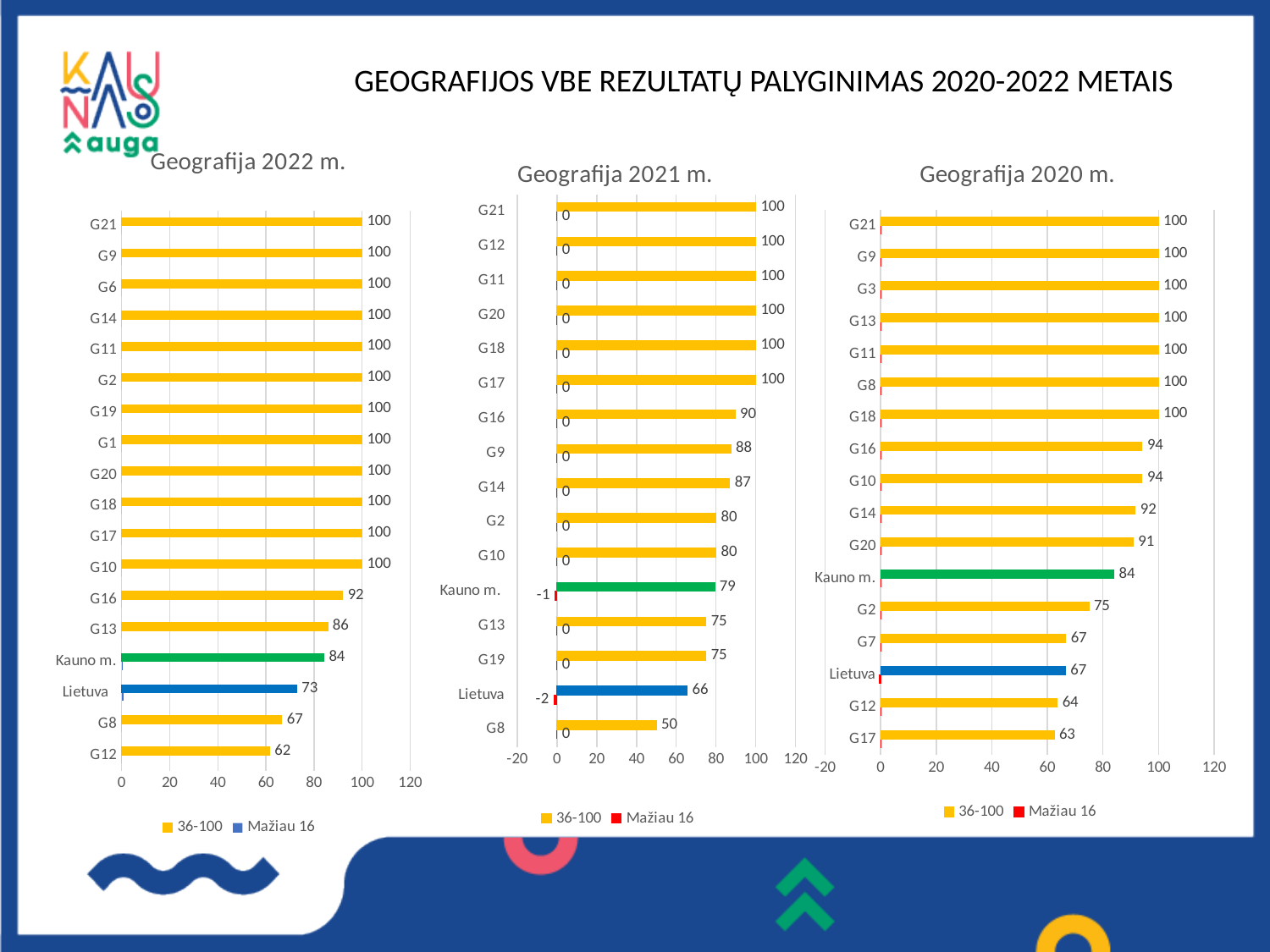
How many series does the legend of the 'Geografija 2022 m.' chart list? 2 In the 'Geografija 2021 m.' chart, how many categories are shown? 16 In the 'Geografija 2020 m.' chart, what is the difference between the values for G16 and G12? 30 In the 'Geografija 2020 m.' chart, what is the value for Kauno m.? 84 In the 'Geografija 2022 m.' chart, what is the difference between the values for Kauno m. and Lietuva? 11 In the 'Geografija 2021 m.' chart, what is the 'Mažiau 16' value for Lietuva? -2 What type of chart is 'Geografija 2020 m.'? Bar chart In the 'Geografija 2022 m.' chart, what is the value for Lietuva? 73 In the 'Geografija 2022 m.' chart, which category has the lowest value? G12 In the 'Geografija 2021 m.' chart, which is larger, the value for G16 or the value for G9? G16 In the 'Geografija 2021 m.' chart, what is the value for G8? 50 In the 'Geografija 2020 m.' chart, which category has the lowest value? G17